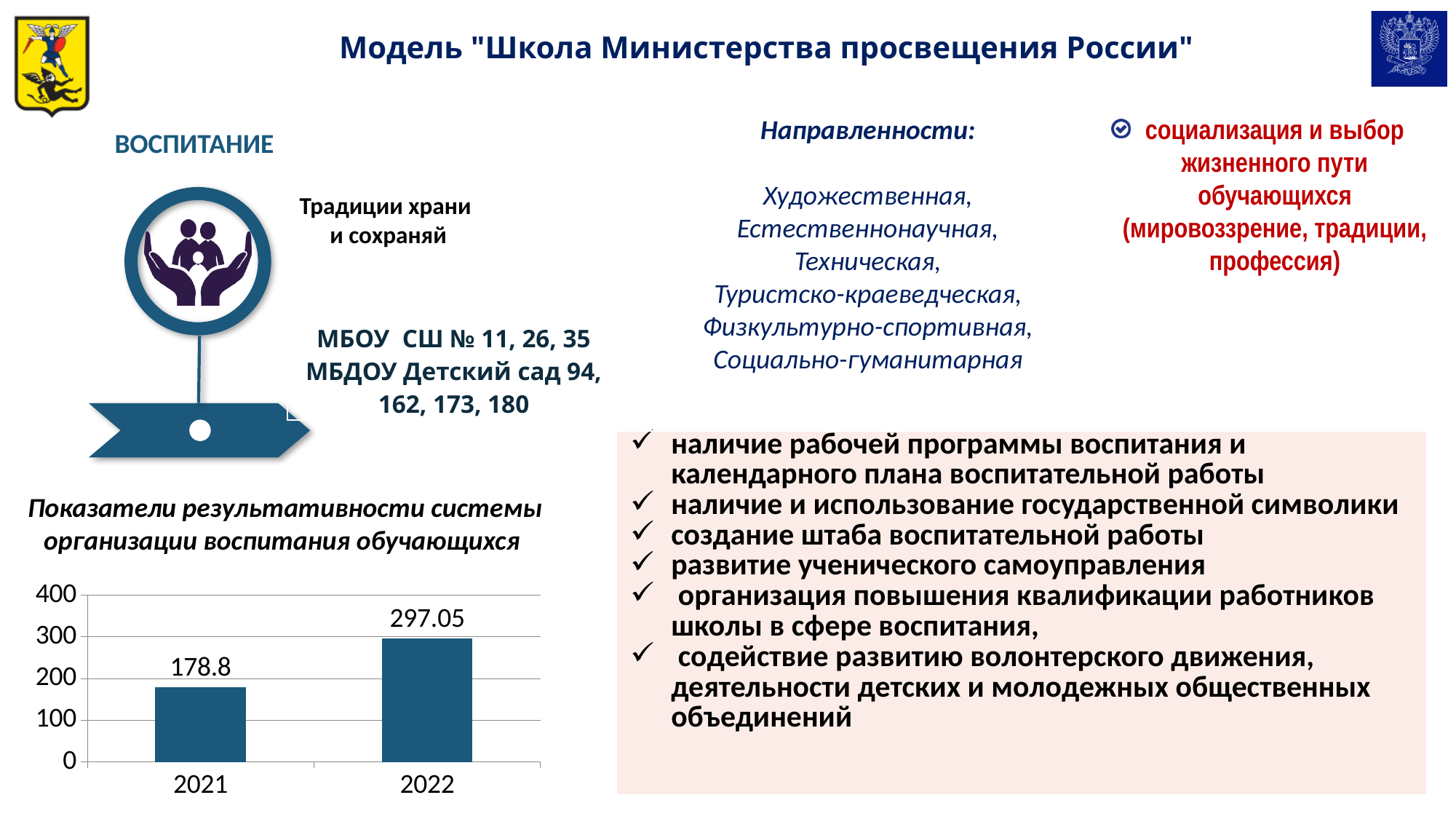
Do the values rise or fall from 2021 to 2022? rise Is the value for 2021 greater or less than 200? less Is the value for 2022 greater or less than 300? less Is the value for 2021 larger or smaller than the value for 2022? smaller Which year has the higher value in the bar chart? 2022 What is the highest tick value on the vertical axis of the bar chart? 400 What kind of chart is shown on the slide? bar chart Which year has the lower value in the bar chart? 2021 How many categories (years) are shown in the bar chart? 2 What is the difference between the 2022 and 2021 values in the bar chart? 118.25 What is the value for 2021 in the bar chart? 178.8 What is the value for 2022 in the bar chart? 297.05